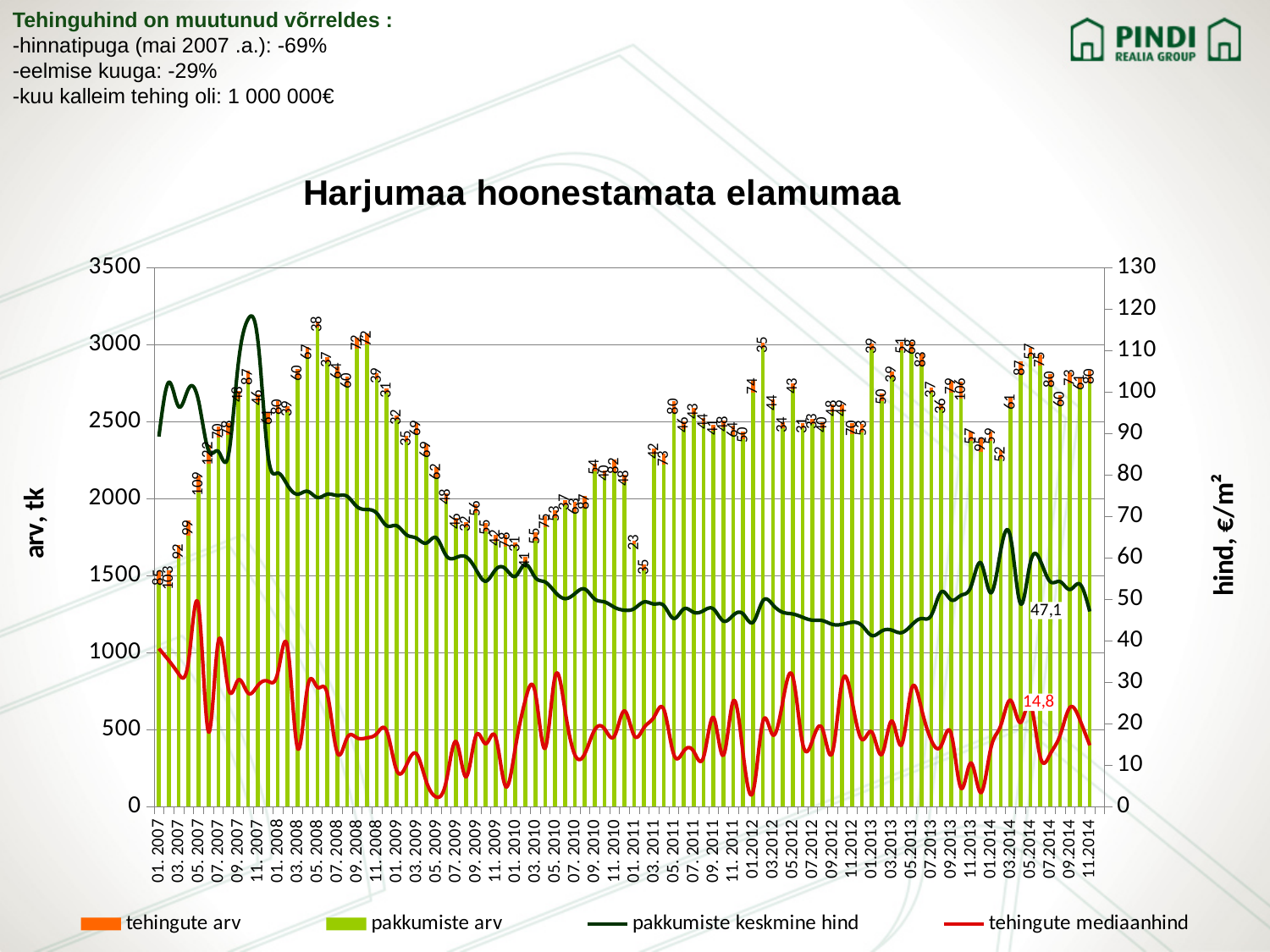
What is the title of the chart? Harjumaa hoonestamata elamumaa Does the pakkumiste keskmine hind line rise or fall between 11.2007 and 11.2009? fall What type of chart is shown on the slide? Combined bar and line chart How many series does the chart legend list? 4 What is the last labelled value of the pakkumiste keskmine hind line? 47,1 In which year does the pakkumiste keskmine hind line reach its highest point? 2007 Is the pakkumiste arv bar for 01.2007 greater or less than 2000? less What is the difference between the last labelled values of pakkumiste keskmine hind (47,1) and tehingute mediaanhind (14,8)? 32,3 Which series are drawn as lines in the chart? pakkumiste keskmine hind and tehingute mediaanhind At the end of the series, which is larger: pakkumiste keskmine hind or tehingute mediaanhind? pakkumiste keskmine hind What is the last labelled value of the tehingute mediaanhind line? 14,8 Is the pakkumiste arv bar for 05.2008 greater or less than 3000? greater